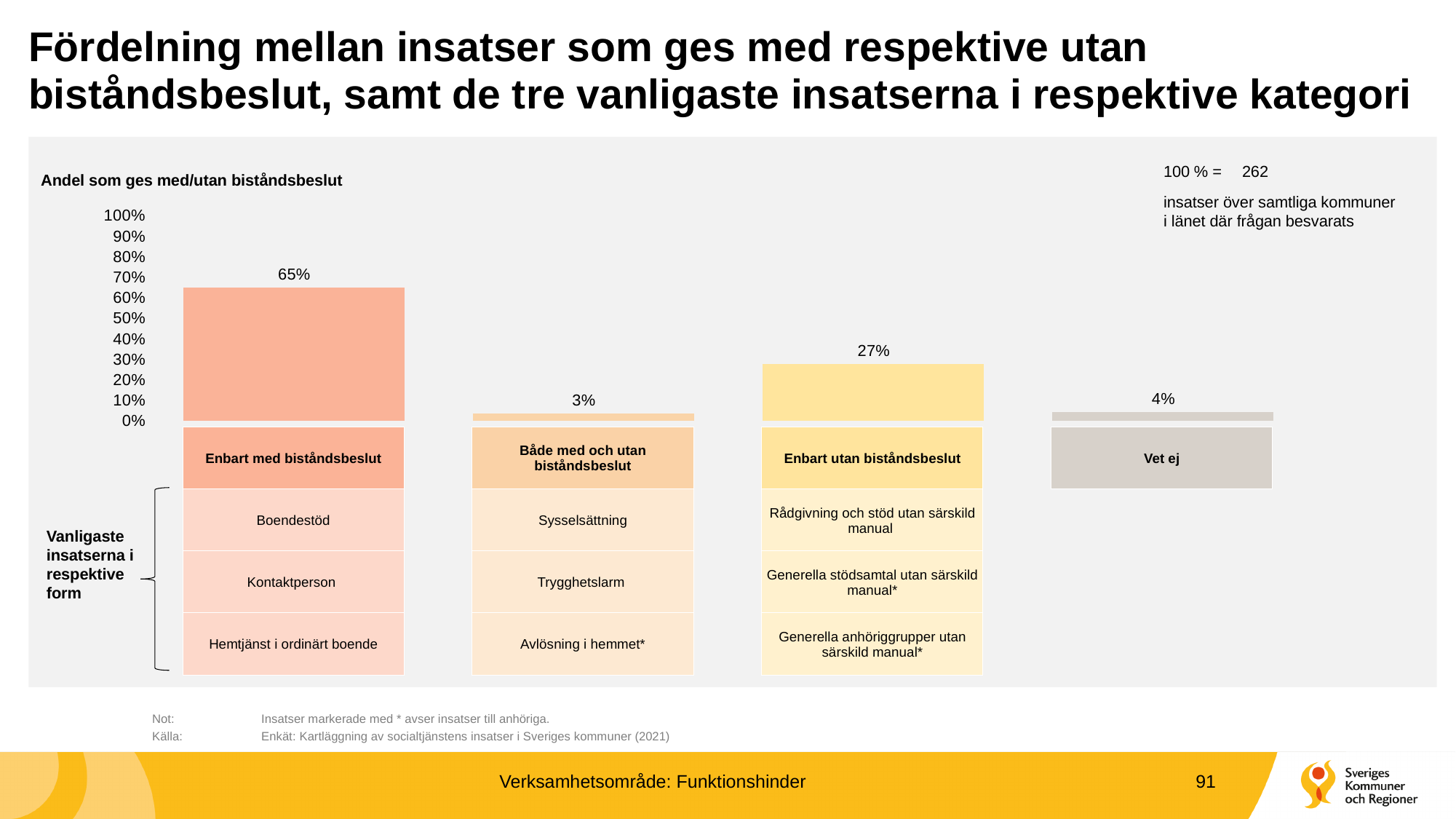
What is the value for "Både med och utan biståndsbeslut"? 3% What is the value for "Enbart med biståndsbeslut"? 65% What kind of chart is shown on the slide? bar chart What is the difference between the values for "Enbart med biståndsbeslut" and "Enbart utan biståndsbeslut"? 38% Which is larger, the value for "Vet ej" or the value for "Både med och utan biståndsbeslut"? Vet ej Which category has the highest value? Enbart med biståndsbeslut How many categories are shown in the bar chart? 4 Which category has the lowest value? Både med och utan biståndsbeslut Is the value for "Enbart utan biståndsbeslut" greater or less than 30%? less What is the value for "Vet ej"? 4% What is the title of the chart? Andel som ges med/utan biståndsbeslut What is the value for "Enbart utan biståndsbeslut"? 27%